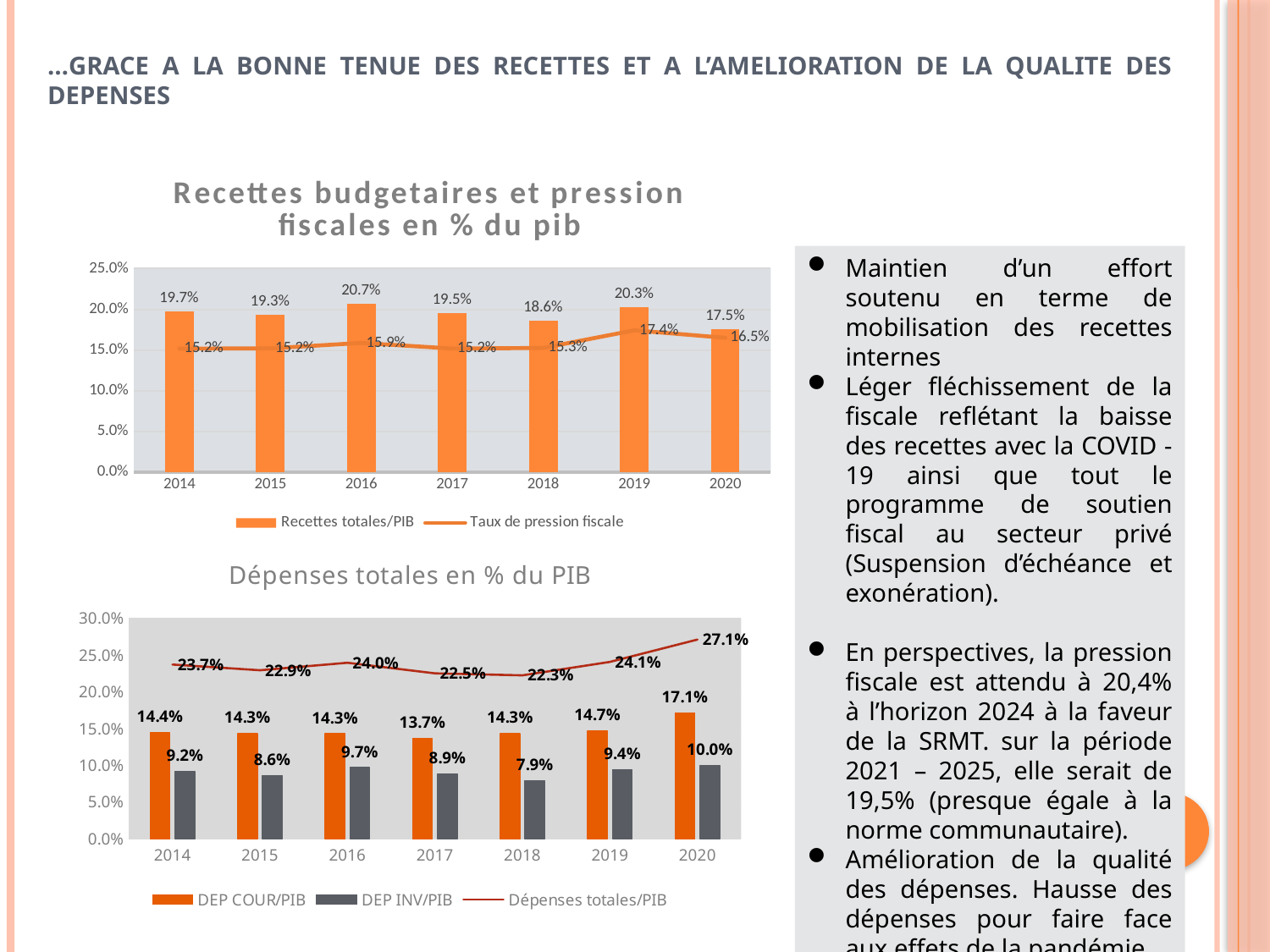
In the chart 'Recettes budgetaires et pression fiscales en % du pib', what is the value of Recettes totales/PIB for 2016? 20.7% In the chart 'Dépenses totales en % du PIB', what is the difference between DEP COUR/PIB and DEP INV/PIB in 2014? 5.2% In the chart 'Recettes budgetaires et pression fiscales en % du pib', how many series does the legend list? 2 In the chart 'Dépenses totales en % du PIB', how many years are shown on the x axis? 7 In the chart 'Dépenses totales en % du PIB', which is larger: DEP INV/PIB in 2016 or DEP INV/PIB in 2015? 2016 In the chart 'Dépenses totales en % du PIB', which year has the highest DEP COUR/PIB? 2020 In the chart 'Recettes budgetaires et pression fiscales en % du pib', what is the difference between Recettes totales/PIB and Taux de pression fiscale in 2020? 1.0% In the chart 'Dépenses totales en % du PIB', what is the value of Dépenses totales/PIB for 2020? 27.1% In the chart 'Recettes budgetaires et pression fiscales en % du pib', what is the Taux de pression fiscale for 2019? 17.4% In the chart 'Dépenses totales en % du PIB', what is the value of DEP INV/PIB for 2018? 7.9% In the chart 'Recettes budgetaires et pression fiscales en % du pib', which year has the lowest Recettes totales/PIB? 2020 What kind of chart is 'Dépenses totales en % du PIB'? Bar chart with a line